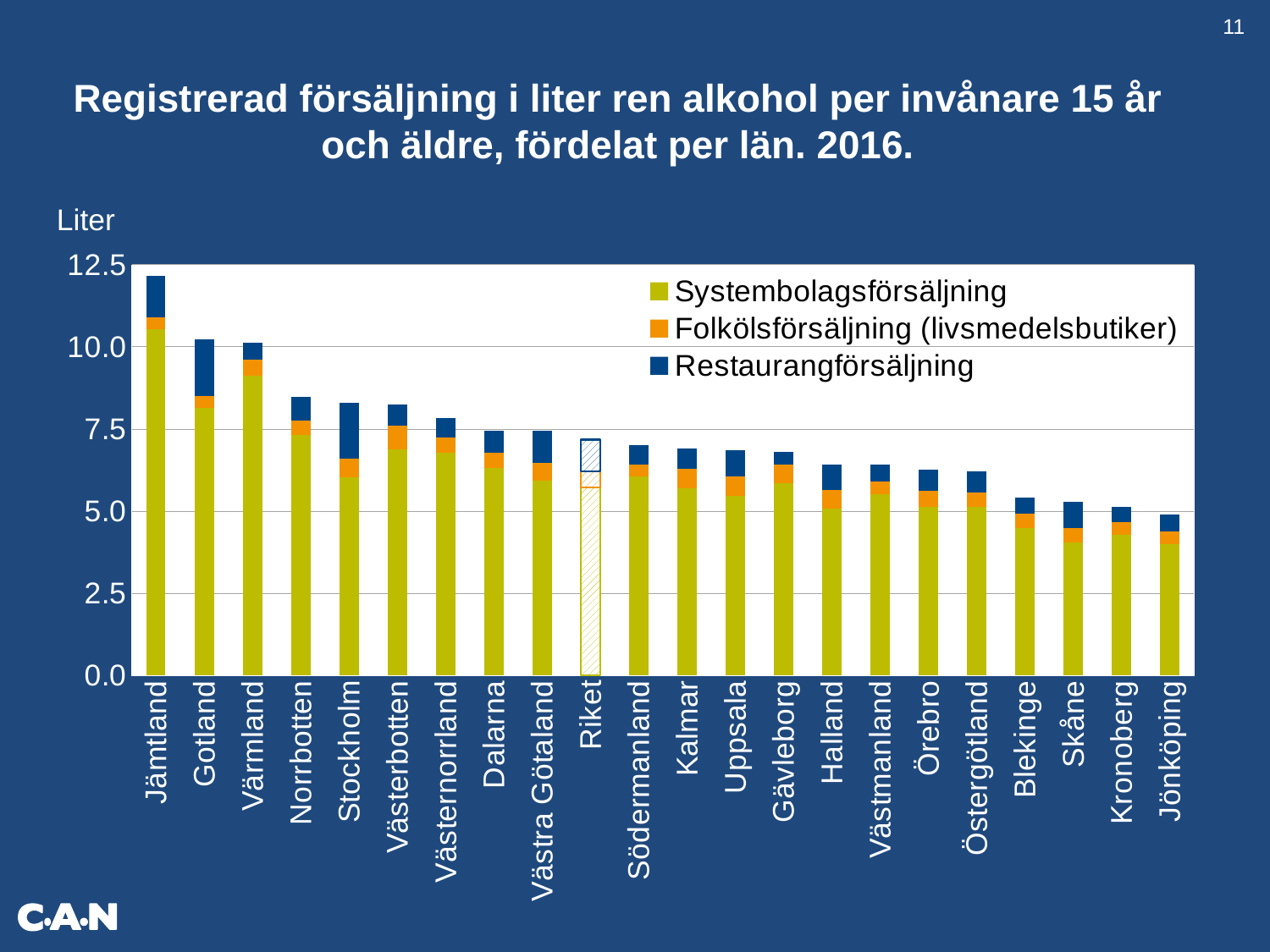
Which has the larger total bar, Stockholm or Halland? Stockholm Do the total bar values generally rise or fall from left to right along the x axis? fall Which series is shown in blue according to the legend? Restaurangförsäljning Which category has the lowest total bar? Jönköping How many categories (bars) are shown along the x axis? 22 Is the total value for Stockholm greater or less than 7.5? greater Is the total value for Jämtland greater or less than 10.0? greater What kind of chart is shown on the slide? Stacked bar chart How many series does the legend list? 3 Which has the larger total bar, Jämtland or Gotland? Jämtland Which category has the highest total bar? Jämtland